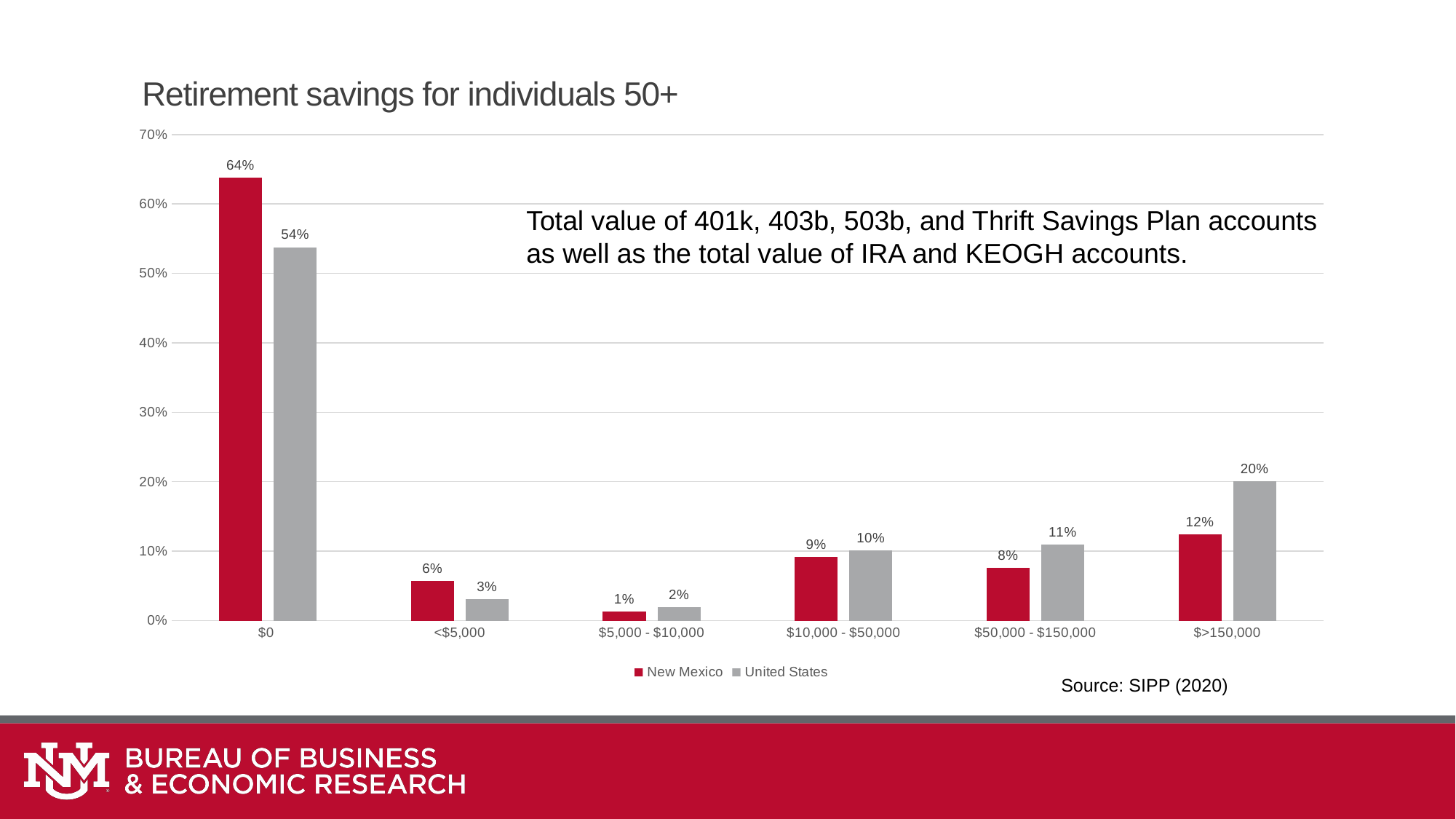
What kind of chart is shown on the slide? Bar chart Which category has the highest value for New Mexico? $0 What is the value for New Mexico in the $0 category? 64% What is the value for United States in the $>150,000 category? 20% Which category has the lowest value for United States? $5,000 - $10,000 What is the value for United States in the $10,000 - $50,000 category? 10% What is the difference between the United States and New Mexico values in the $>150,000 category? 8% What is the difference between the New Mexico and United States values in the $0 category? 10% In the <$5,000 category, which is larger: New Mexico or United States? New Mexico How many categories are shown on the x axis? 6 How many series does the legend list? 2 Is the value for United States in the $0 category greater or less than 50%? greater